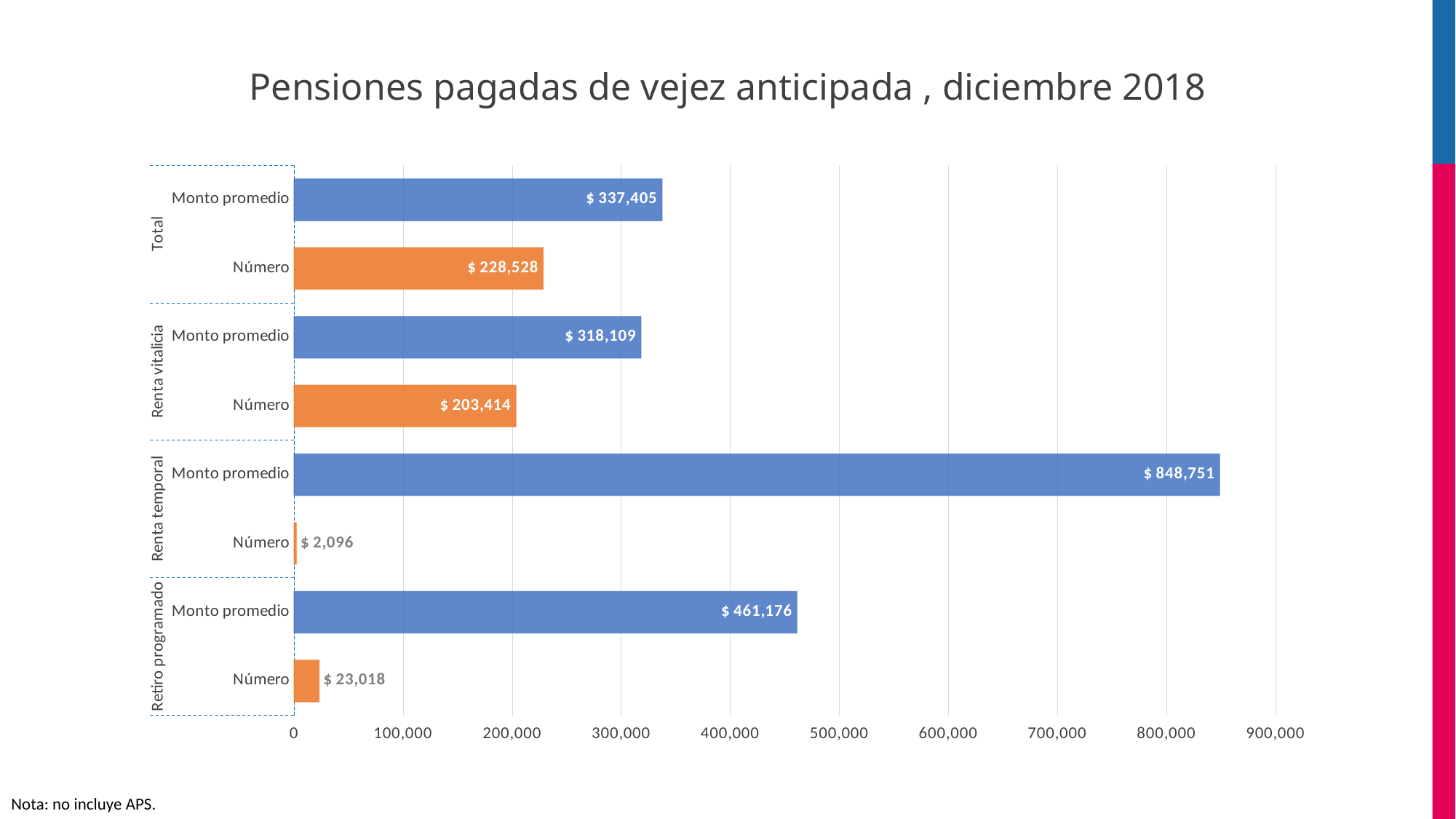
What is the value of Número for Total? $ 228,528 What kind of chart is shown on the slide? bar chart What is the difference between the Monto promedio for Total and the Monto promedio for Renta vitalicia? $ 19,296 Which group has the highest Monto promedio? Renta temporal Which is larger: the Monto promedio for Retiro programado or the Monto promedio for Total? Retiro programado Which group has the lowest Número? Renta temporal Is the Monto promedio for Renta temporal greater or less than 800,000? greater What is the value of Monto promedio for Renta temporal? $ 848,751 What is the value of Monto promedio for Renta vitalicia? $ 318,109 What is the value of Número for Retiro programado? $ 23,018 What is the difference between the Número for Total and the Número for Renta vitalicia? $ 25,114 How many bars are plotted in the chart? 8